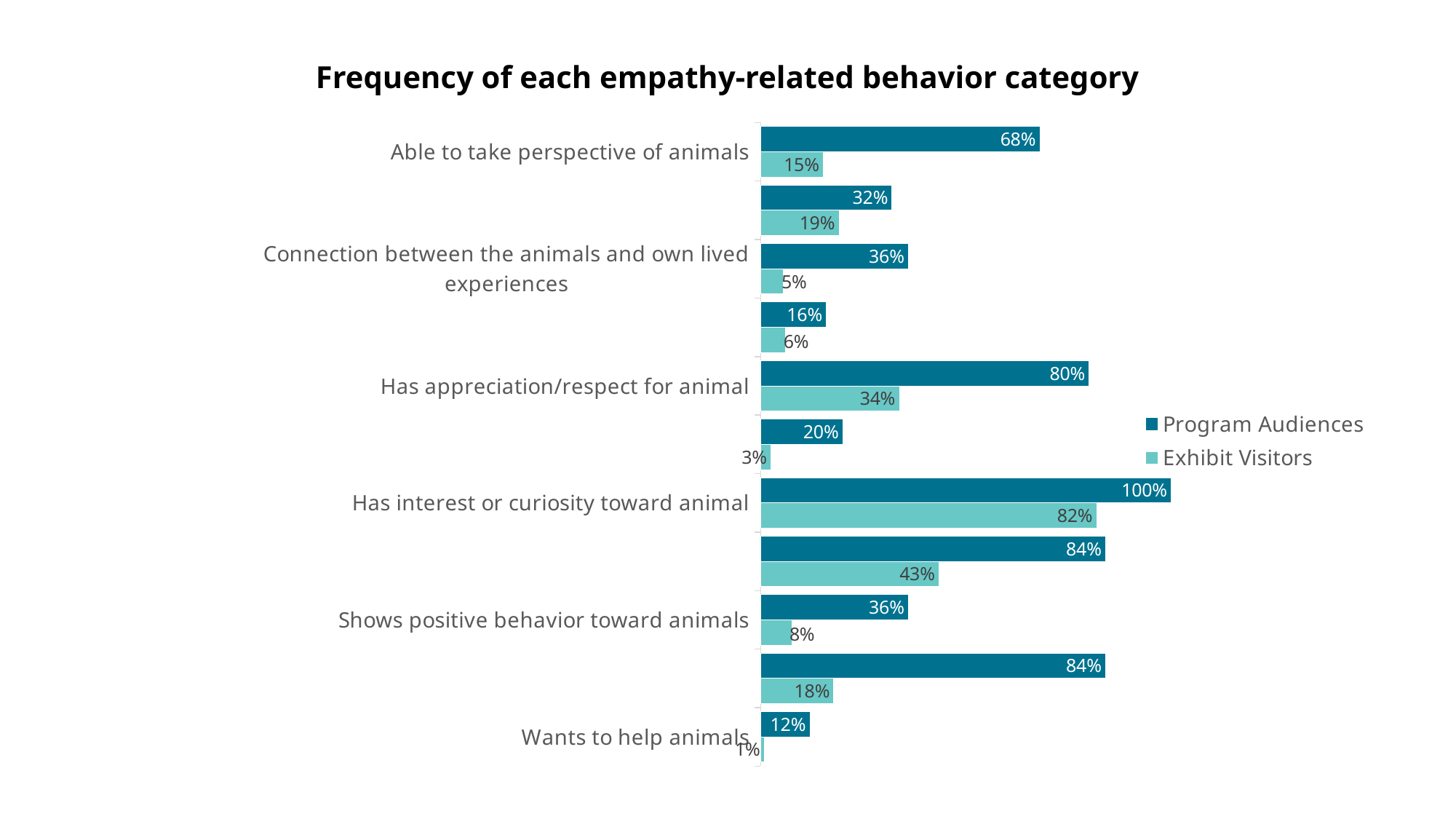
What is the Program Audiences value for "Shows positive behavior toward animals"? 36% What is the Exhibit Visitors value for "Has appreciation/respect for animal"? 34% What is the Program Audiences value for "Able to take perspective of animals"? 68% What is the difference between the Program Audiences and Exhibit Visitors values for "Able to take perspective of animals"? 53 percentage points Which category has the lowest Exhibit Visitors value? Wants to help animals Which is larger: the Exhibit Visitors value for "Has appreciation/respect for animal" or for "Shows positive behavior toward animals"? Has appreciation/respect for animal What is the difference between the Program Audiences and Exhibit Visitors values for "Has interest or curiosity toward animal"? 18 percentage points Which category has the highest Program Audiences value? Has interest or curiosity toward animal What is the Exhibit Visitors value for "Has interest or curiosity toward animal"? 82% What is the Exhibit Visitors value for "Wants to help animals"? 1% How many series does the legend list? 2 What kind of chart is shown on the slide? Bar chart